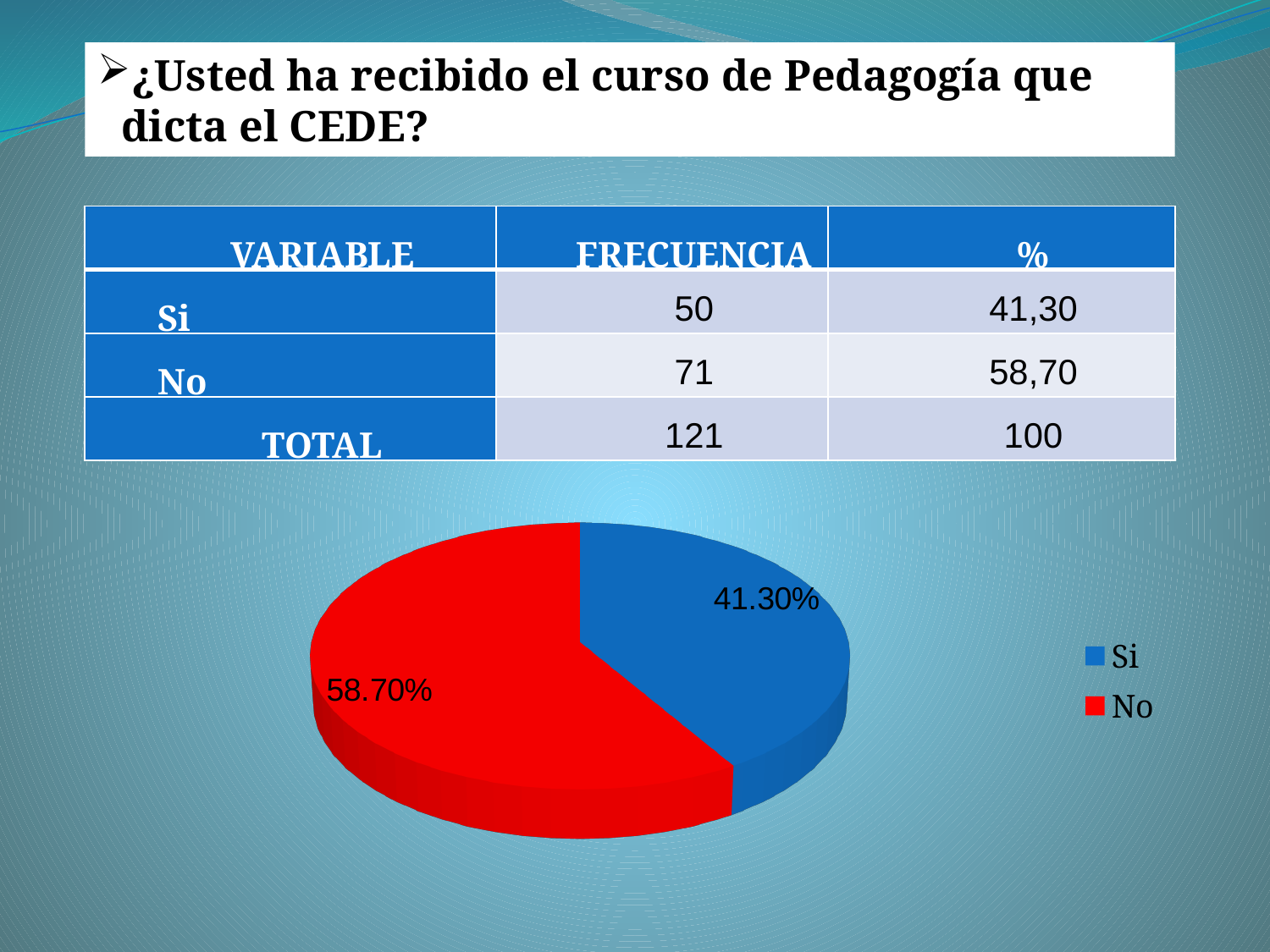
Which category has the smallest slice in the pie chart? Si How many entries does the legend of the pie chart list? 2 What percentage does the pie chart show for Si? 41.30% How many slices does the pie chart have? 2 Which category has the largest slice in the pie chart? No Which slice is larger in the pie chart, Si or No? No What colour is the Si slice in the pie chart? blue What is the difference in percentage points between the No slice and the Si slice? 17.40 What colour is the No slice in the pie chart? red Is the share for Si in the pie chart greater or less than 50%? less What kind of chart is shown on the slide? pie chart What percentage does the pie chart show for No? 58.70%